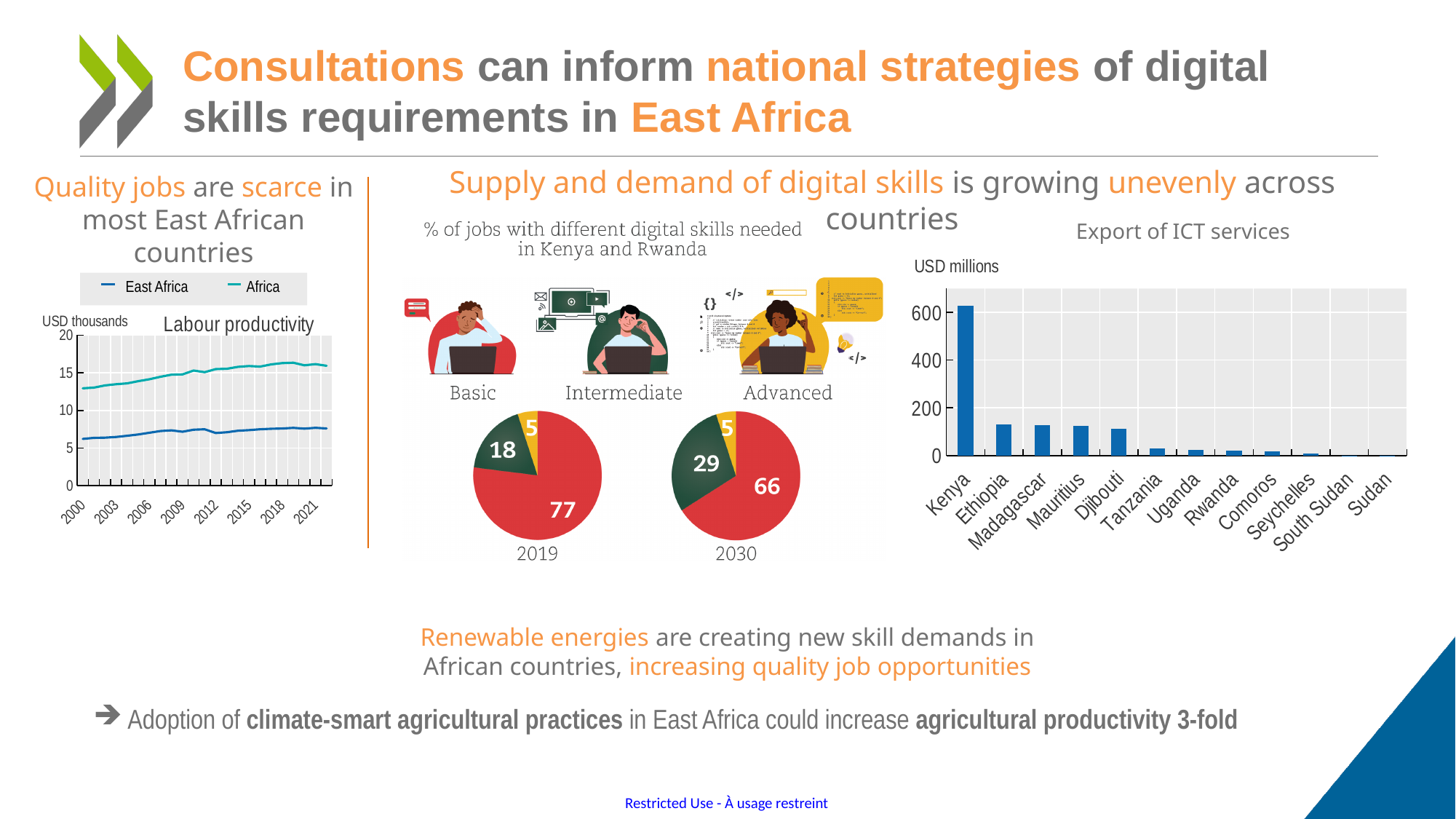
In the Export of ICT services chart, is the value for Kenya greater or less than 600? greater In the Export of ICT services chart, which is larger, the value for Djibouti or the value for Tanzania? Djibouti In the Labour productivity chart, is the value for Africa in 2021 greater or less than 15? greater In the Export of ICT services chart, what unit is shown on the y axis? USD millions In the Export of ICT services chart, how many countries are shown on the x axis? 12 What is the difference between the Basic (red) slice in the 2019 pie chart and the Basic (red) slice in the 2030 pie chart? 11 What kind of chart is the Export of ICT services chart? bar chart How many series does the legend of the Labour productivity chart list? 2 In the 2030 pie chart of digital skills needed in Kenya and Rwanda, what is the value of the Intermediate (dark green) slice? 29 In the Export of ICT services chart, which country has the highest value? Kenya In the Export of ICT services chart, is the value for Ethiopia greater or less than 200? less In the 2019 pie chart of digital skills needed in Kenya and Rwanda, what is the value of the largest slice? 77